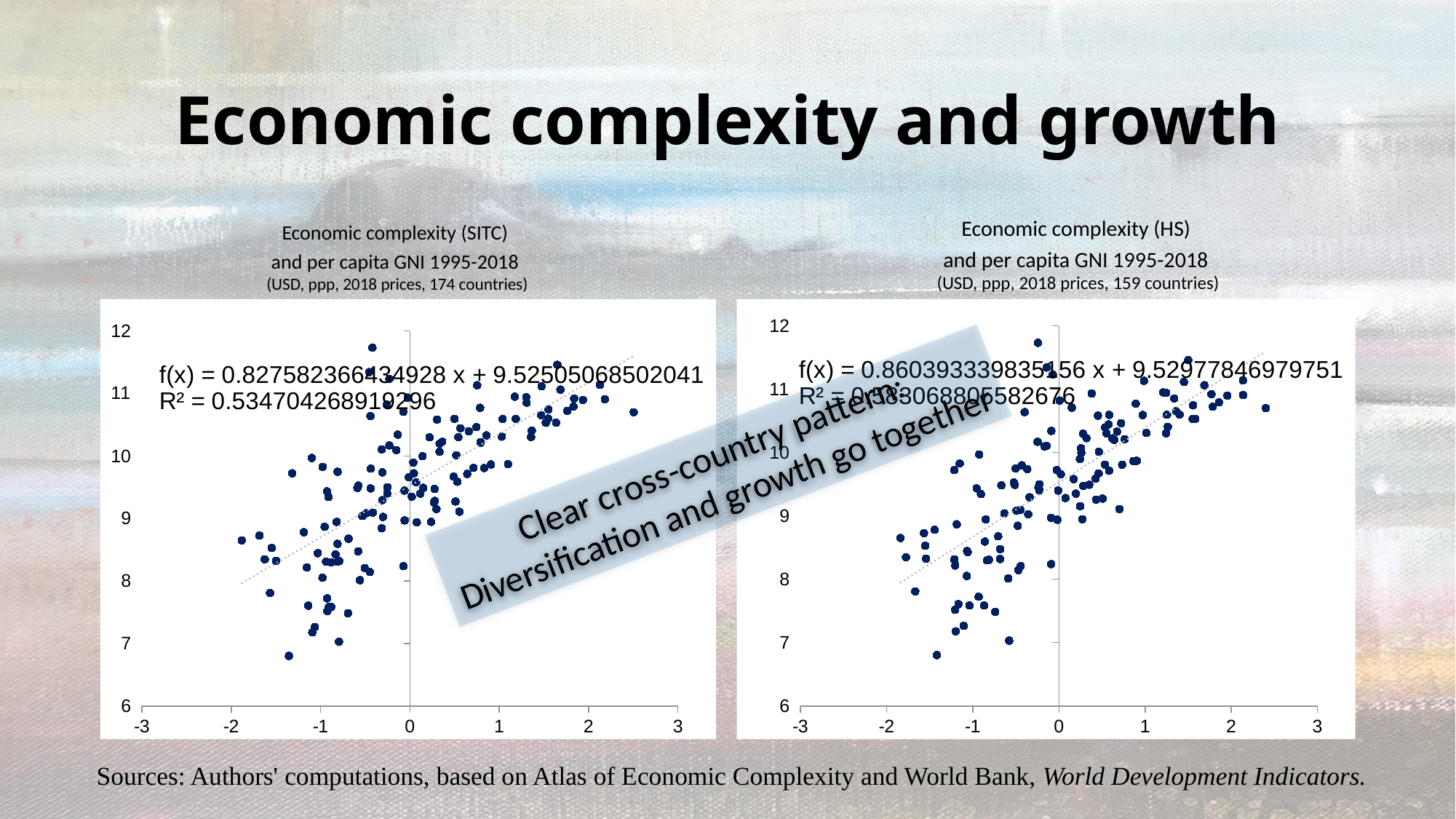
In the right chart (HS), do the plotted values tend to rise or fall as economic complexity increases along the x axis? Rise In the left chart (SITC), do the plotted values tend to rise or fall as economic complexity increases along the x axis? Rise Which chart has the steeper fitted-line slope, the left chart (SITC) or the right chart (HS)? The right chart (HS) What is the slope of the fitted line shown on the right chart (HS)? 0.860393339835156 In the left chart (SITC), is the highest plotted point greater or less than 11 on the y axis? greater What is the intercept of the fitted line shown on the left chart (SITC)? 9.52505068502041 What is the slope of the fitted line shown on the left chart (SITC)? 0.827582366434928 According to its title, how many countries are included in the left chart (SITC)? 174 countries According to its title, how many countries are included in the right chart (HS)? 159 countries What R² value is shown on the left chart (SITC)? 0.534704268910296 What is the intercept of the fitted line shown on the right chart (HS)? 9.52977846979751 What kind of chart is the left chart, 'Economic complexity (SITC) and per capita GNI 1995-2018'? Scatter chart